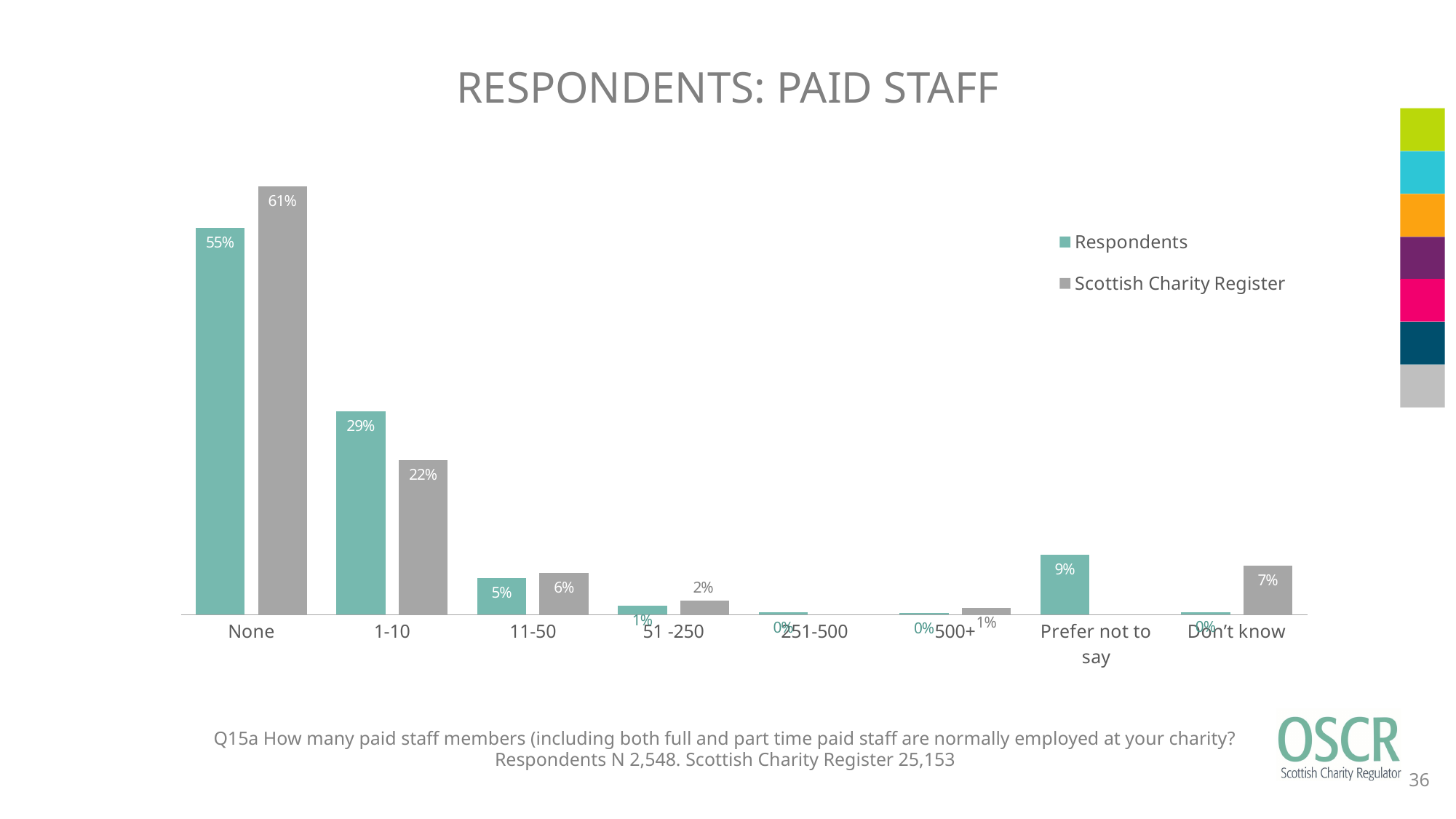
How many series does the legend list? 2 What type of chart is shown on the slide? Bar chart For the 'Don't know' category, which series has the larger value, Respondents or Scottish Charity Register? Scottish Charity Register What is the difference between the Scottish Charity Register and Respondents values for the None category? 6% What is the Scottish Charity Register value for 11-50 paid staff? 6% What percentage of Respondents have no paid staff (None)? 55% What is the difference between the Respondents and Scottish Charity Register values for 1-10 paid staff? 7% How many categories are shown on the x axis? 8 Which category has the highest Respondents value? None What percentage of Respondents have 1-10 paid staff? 29% What is the Scottish Charity Register value for the None category? 61% What percentage of Respondents chose 'Prefer not to say'? 9%